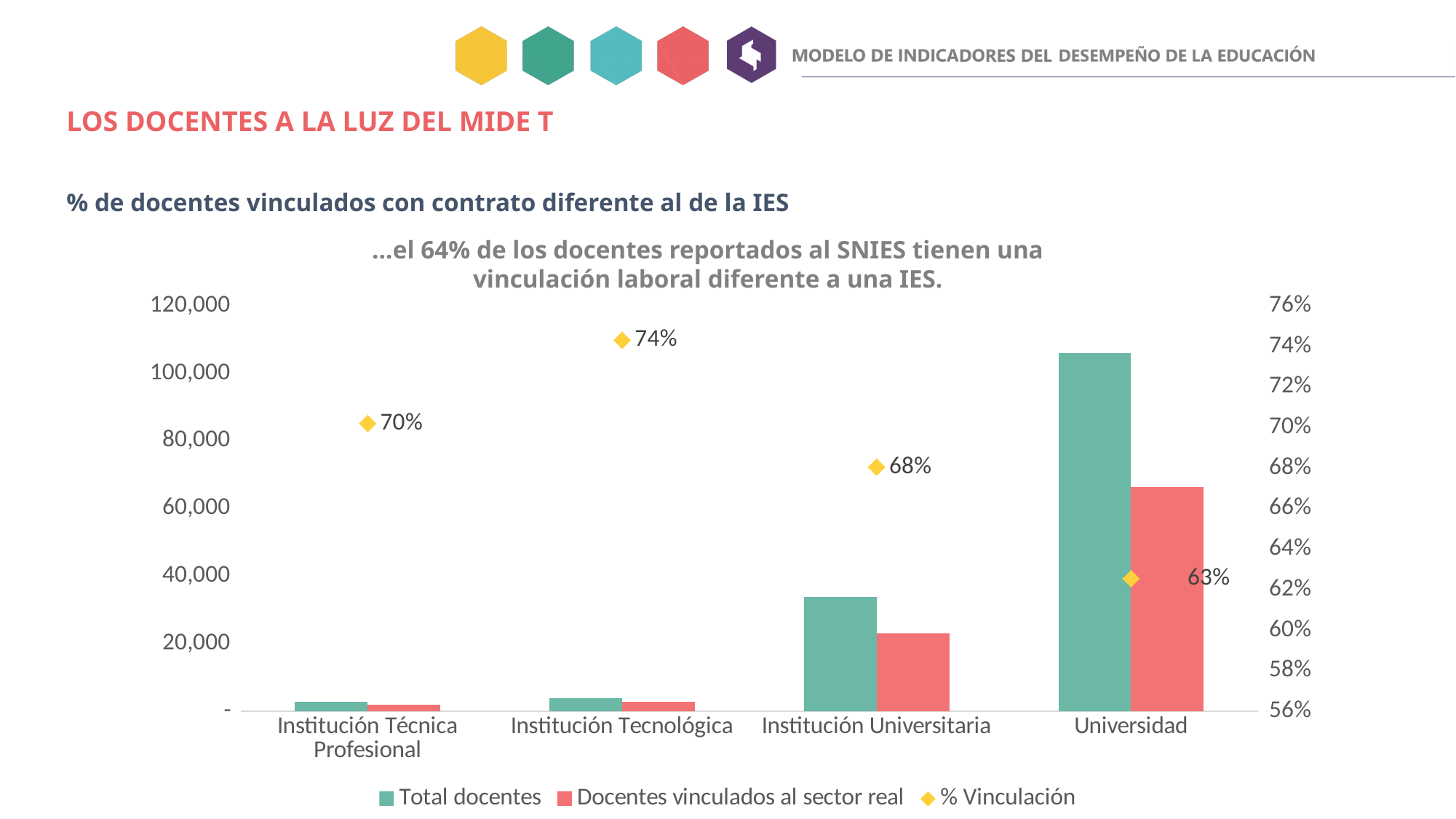
Is the Total docentes value for Universidad greater or less than 100,000? greater How many categories are shown on the x axis? 4 Which category has the lowest % Vinculación? Universidad What is the % Vinculación value for Universidad? 63% How many series does the legend list? 3 What is the % Vinculación value for Institución Técnica Profesional? 70% Is the Total docentes value for Institución Universitaria greater or less than 40,000? less What is the difference in % Vinculación between Institución Tecnológica and Universidad? 11 percentage points What is the % Vinculación value for Institución Tecnológica? 74% Which category has the tallest Total docentes bar? Universidad Which category has the highest % Vinculación? Institución Tecnológica Which has a higher % Vinculación, Institución Técnica Profesional or Institución Universitaria? Institución Técnica Profesional